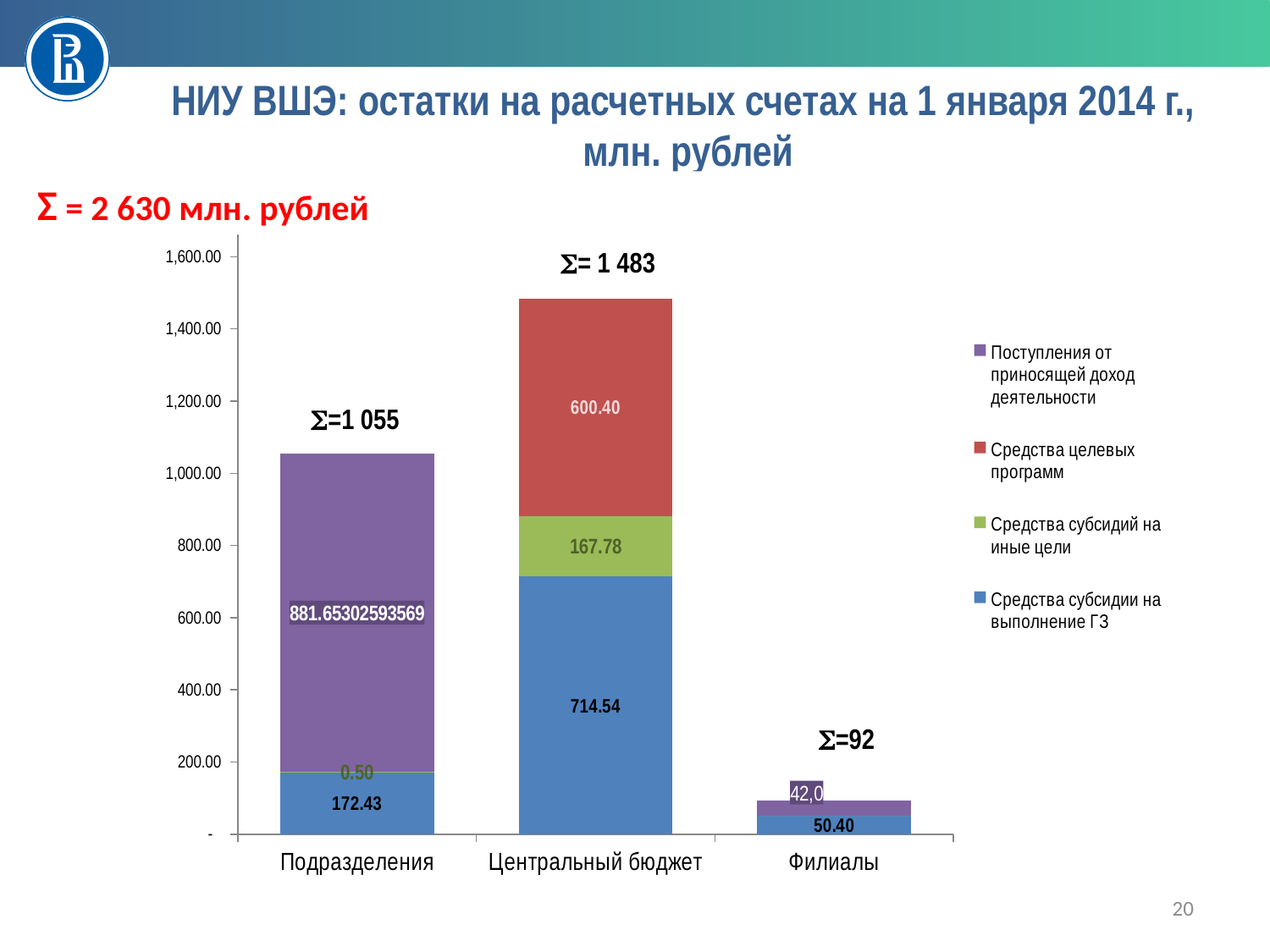
What is the value of Средства субсидии на выполнение ГЗ for Филиалы? 50.40 What is the value of Средства субсидии на выполнение ГЗ for Подразделения? 172.43 What is the value of Средства субсидий на иные цели for Центральный бюджет? 167.78 Which category has the highest total? Центральный бюджет What is the value of Средства субсидии на выполнение ГЗ for Центральный бюджет? 714.54 What kind of chart is shown on the slide? stacked bar chart How many categories are shown on the x axis of the chart? 3 Which category has the lowest total? Филиалы What is the value of Средства целевых программ for Центральный бюджет? 600.40 What is the total (Σ) shown for the Центральный бюджет bar? 1 483 How many series does the chart legend list? 4 What is the difference between the Средства субсидии на выполнение ГЗ values for Центральный бюджет and Подразделения? 542.11